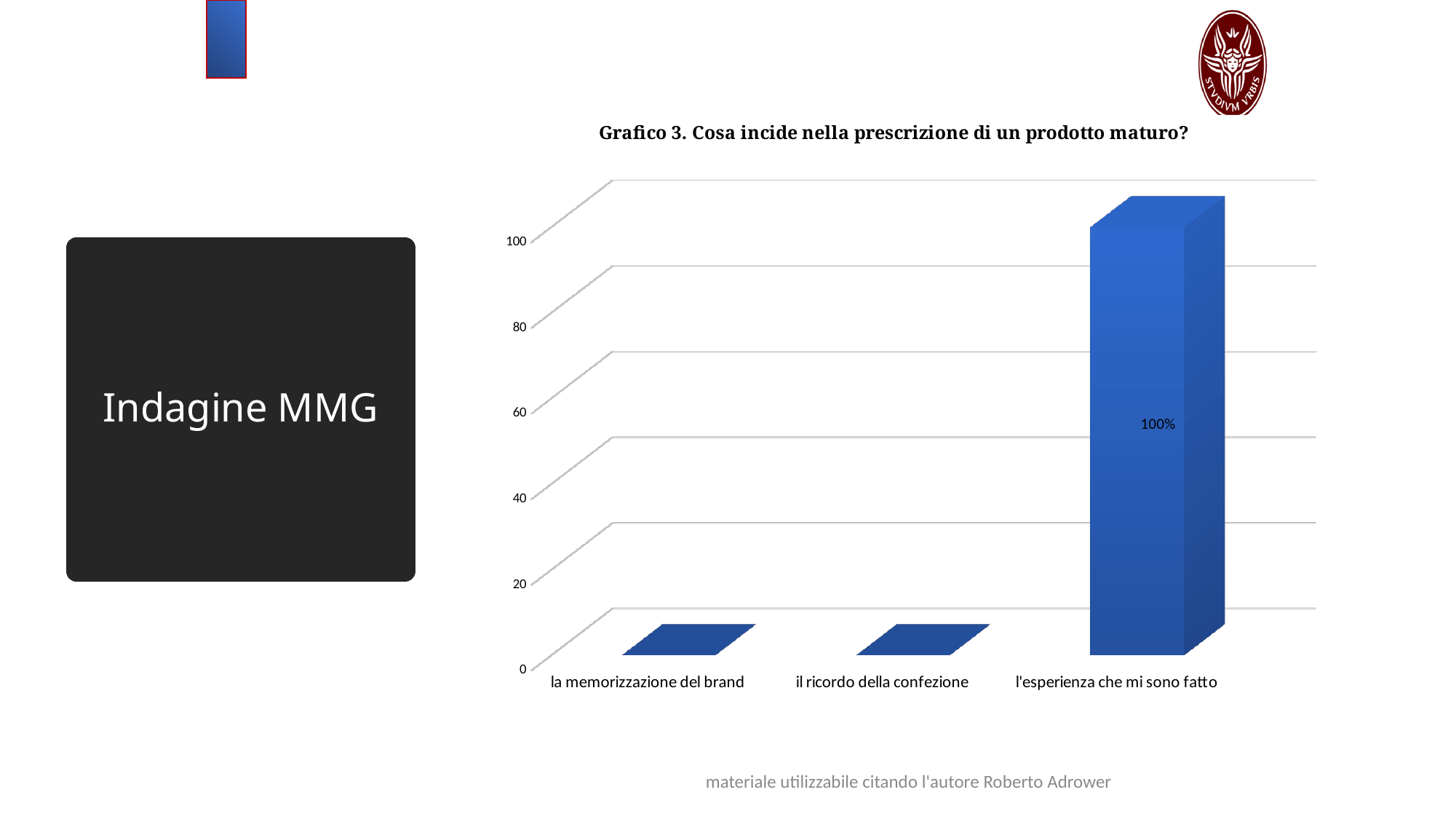
Which category has the highest value in the chart? l'esperienza che mi sono fatto Which is larger: the value for "l'esperienza che mi sono fatto" or the value for "la memorizzazione del brand"? l'esperienza che mi sono fatto Is the value for "il ricordo della confezione" greater or less than 20? less Is the value for "la memorizzazione del brand" greater or less than 20? less How many categories are shown on the x axis of the chart? 3 What is the highest tick value shown on the vertical axis of the chart? 100 Is the value for "l'esperienza che mi sono fatto" greater or less than 80? greater What is the value shown for "l'esperienza che mi sono fatto"? 100% What kind of chart is shown on the slide? bar chart Which is larger: the value for "il ricordo della confezione" or the value for "l'esperienza che mi sono fatto"? l'esperienza che mi sono fatto What is the title of the chart? Grafico 3. Cosa incide nella prescrizione di un prodotto maturo?